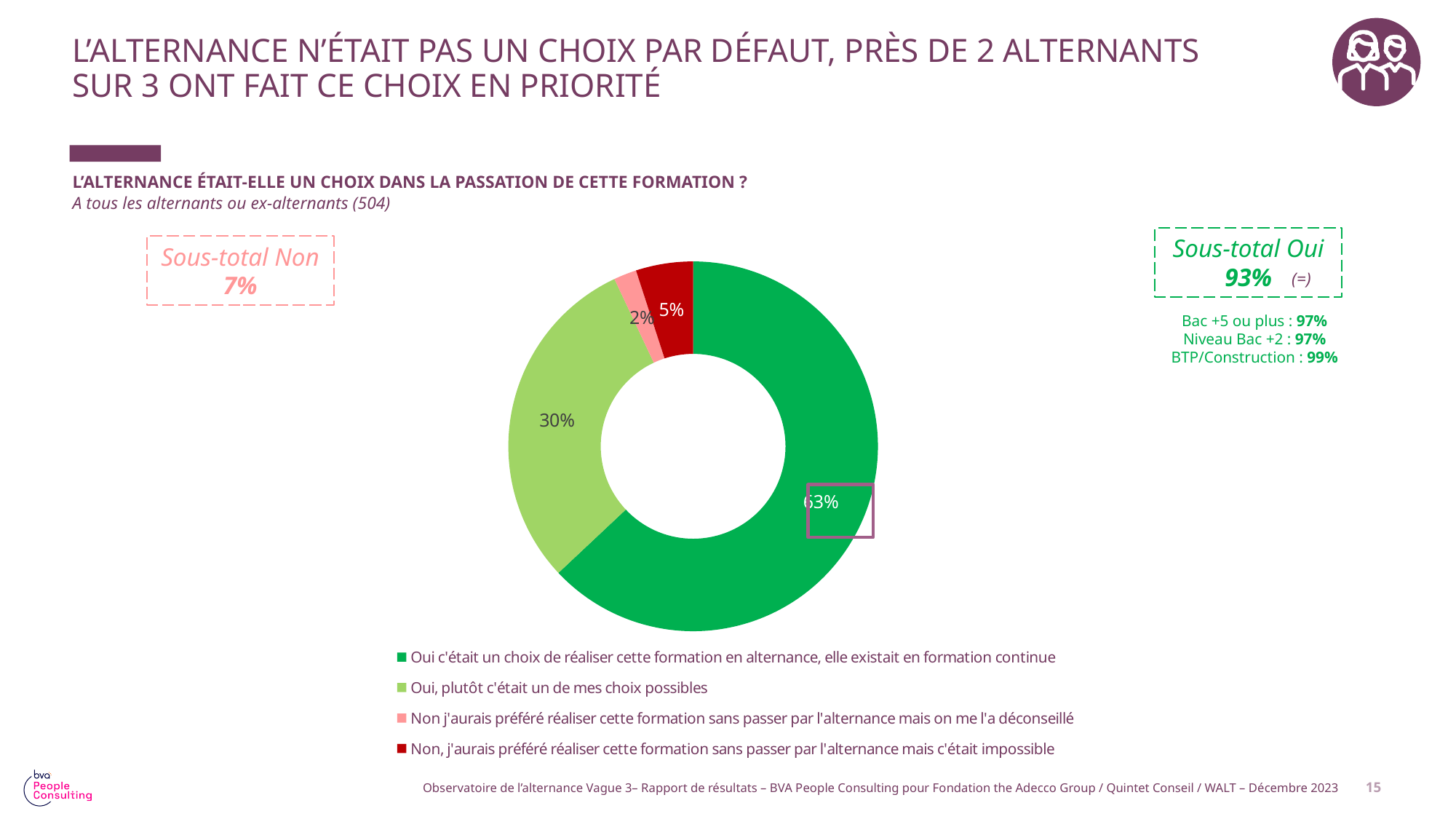
Which response has the smallest share of the donut chart? Non j'aurais préféré réaliser cette formation sans passer par l'alternance mais on me l'a déconseillé What kind of chart is shown on the slide? Donut (pie) chart How many slices does the donut chart have? 4 What percentage is shown for "Non, j'aurais préféré réaliser cette formation sans passer par l'alternance mais c'était impossible"? 5% What is the "Sous-total Oui" value shown on the slide? 93% Which is larger: the share for "c'était impossible" or the share for "on me l'a déconseillé"? c'était impossible (5%) Which response has the largest share of the donut chart? Oui c'était un choix de réaliser cette formation en alternance, elle existait en formation continue What percentage is shown for "Non j'aurais préféré réaliser cette formation sans passer par l'alternance mais on me l'a déconseillé"? 2% What percentage is shown for "Oui c'était un choix de réaliser cette formation en alternance, elle existait en formation continue"? 63% What percentage is shown for "Oui, plutôt c'était un de mes choix possibles"? 30% How many entries does the legend list? 4 What is the difference between the 30% slice and the 5% slice? 25 percentage points